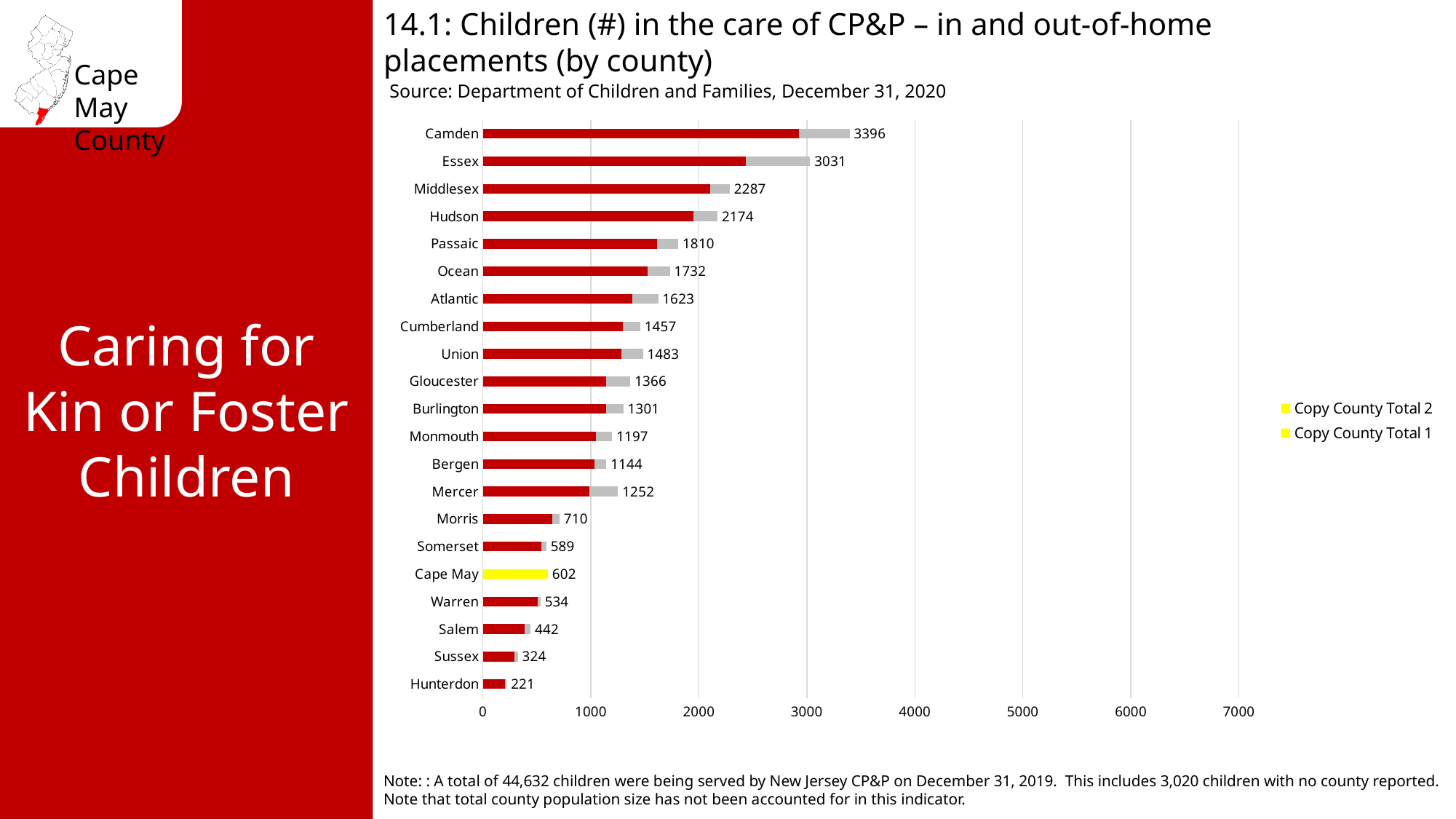
What is the total number of children in the care of CP&P for Camden? 3396 Which county has the lowest total number of children in the care of CP&P? Hunterdon How many counties are shown on the chart? 21 What is the total number of children in the care of CP&P for Cape May? 602 Is the total for Passaic greater or less than 2000? less What kind of chart is shown on the slide? Bar chart Which county's bar is highlighted in yellow? Cape May What is the difference between the totals for Camden and Essex? 365 Which county has a larger total, Mercer or Bergen? Mercer How many entries does the legend list? 2 Which county has the highest total number of children in the care of CP&P? Camden What is the total number of children in the care of CP&P for Hunterdon? 221